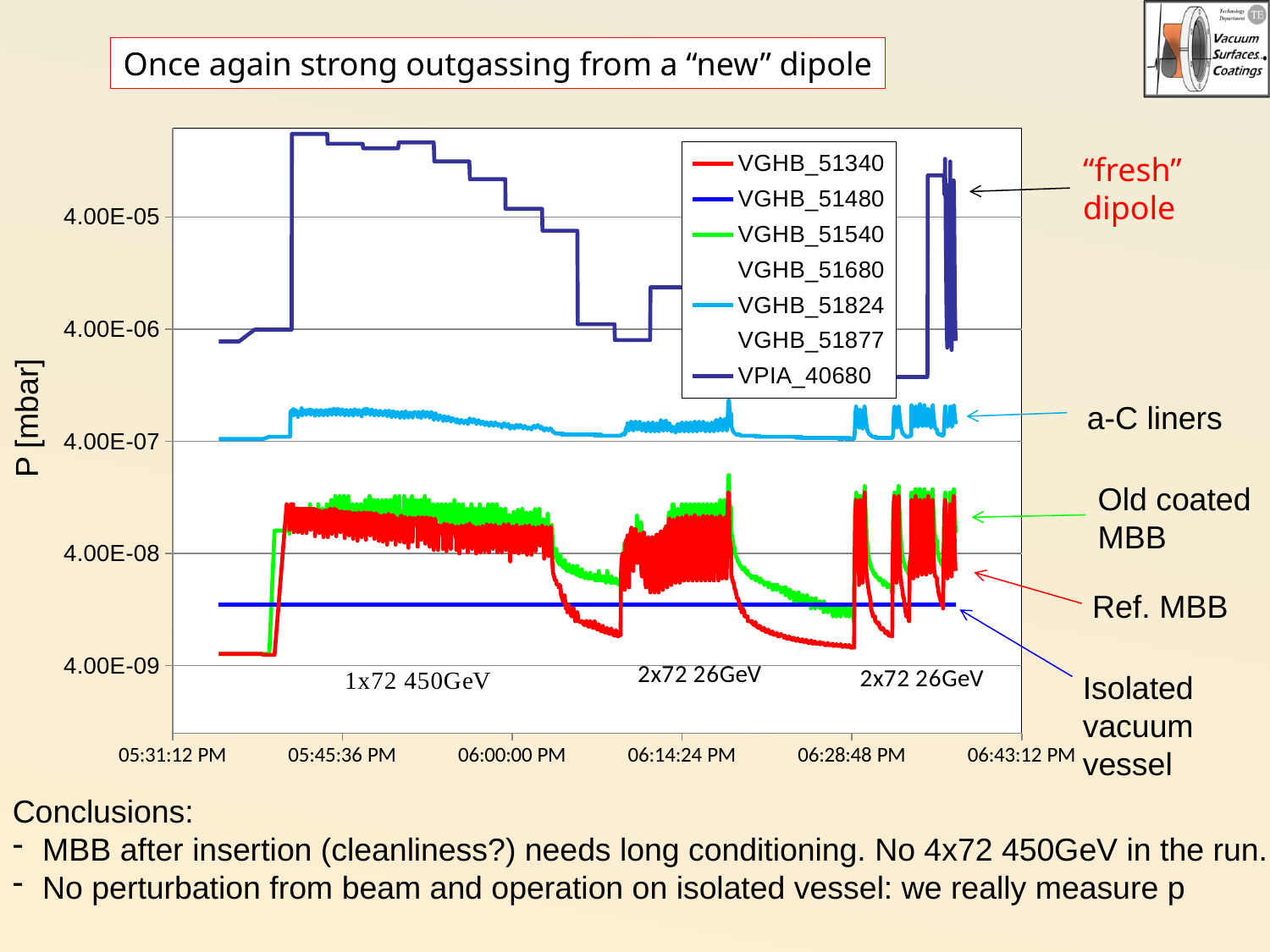
Which series reaches the highest pressure values on the chart? VPIA_40680 Is the peak value of VPIA_40680 around 05:45:36 PM greater or less than 4.00E-05? greater Is the value of VGHB_51824 at 06:00:00 PM greater or less than 4.00E-06? less Is the value of VGHB_51480 greater or less than 4.00E-08? less What is the title shown above the chart? Once again strong outgassing from a "new" dipole Which series has higher values, VPIA_40680 or VGHB_51824? VPIA_40680 How many series does the chart legend list? 7 What is the label of the y-axis? P [mbar] Does VPIA_40680 rise or fall between 05:45:36 PM and 06:14:24 PM? fall What kind of chart is shown on the slide? line chart How many time labels are shown on the x-axis? 6 Which series has higher values at 06:00:00 PM, VGHB_51824 or VGHB_51340? VGHB_51824